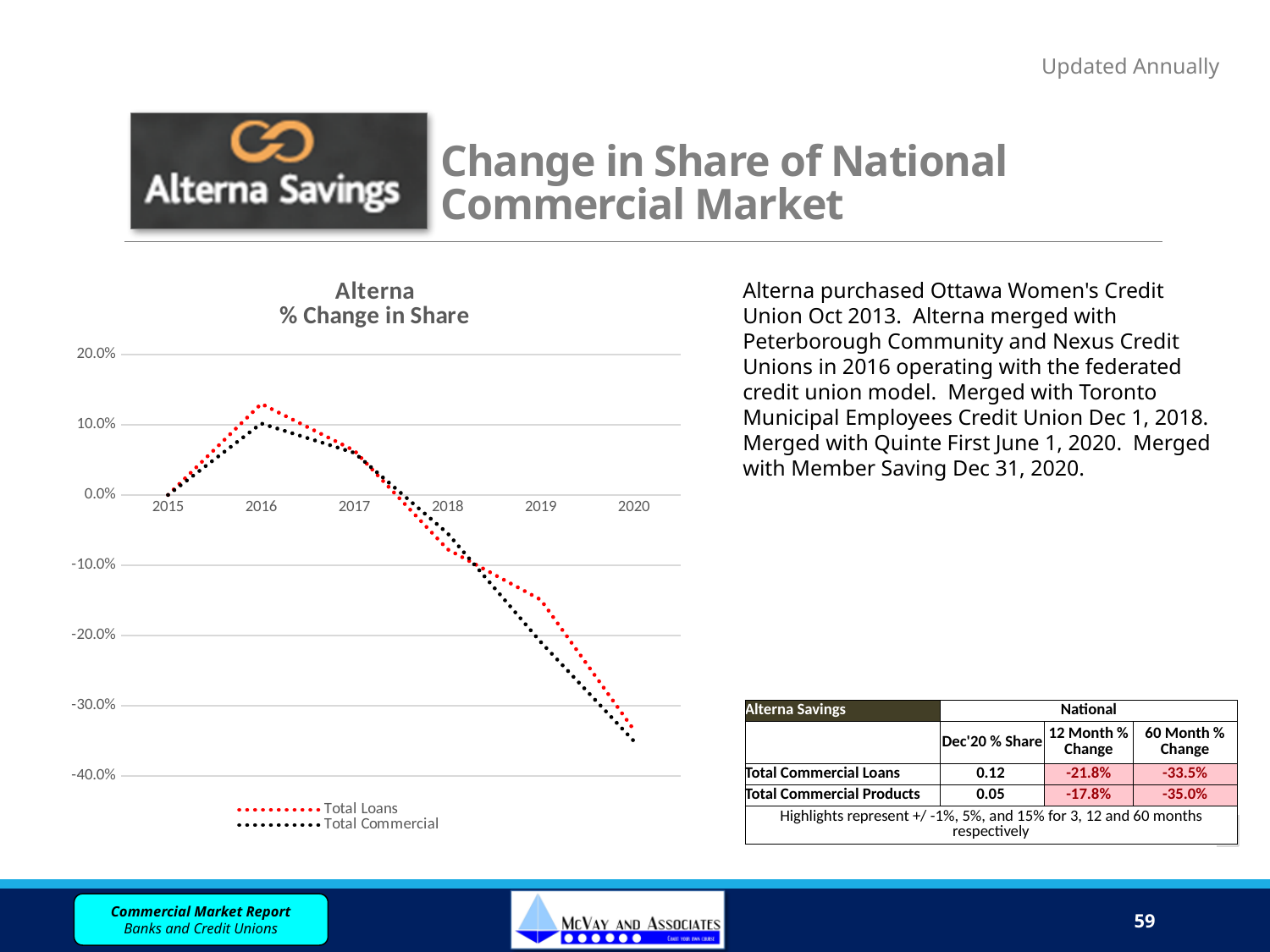
Is the value for Total Loans in 2020 greater or less than -30.0%? less Is the value for Total Commercial in 2019 greater or less than -10.0%? less Do the values for Total Commercial rise or fall from 2016 to 2020? fall What is the value for Total Loans in 2015? 0.0% What type of chart is shown on the slide? Line chart In which year does the Total Loans series reach its highest value? 2016 Which series is drawn with the red dotted line? Total Loans How many series does the chart legend list? 2 In 2016, which series has the higher value, Total Loans or Total Commercial? Total Loans How many years are plotted along the x axis of the chart? 6 What is the title of the chart? Alterna % Change in Share In which year does the Total Commercial series reach its lowest value? 2020